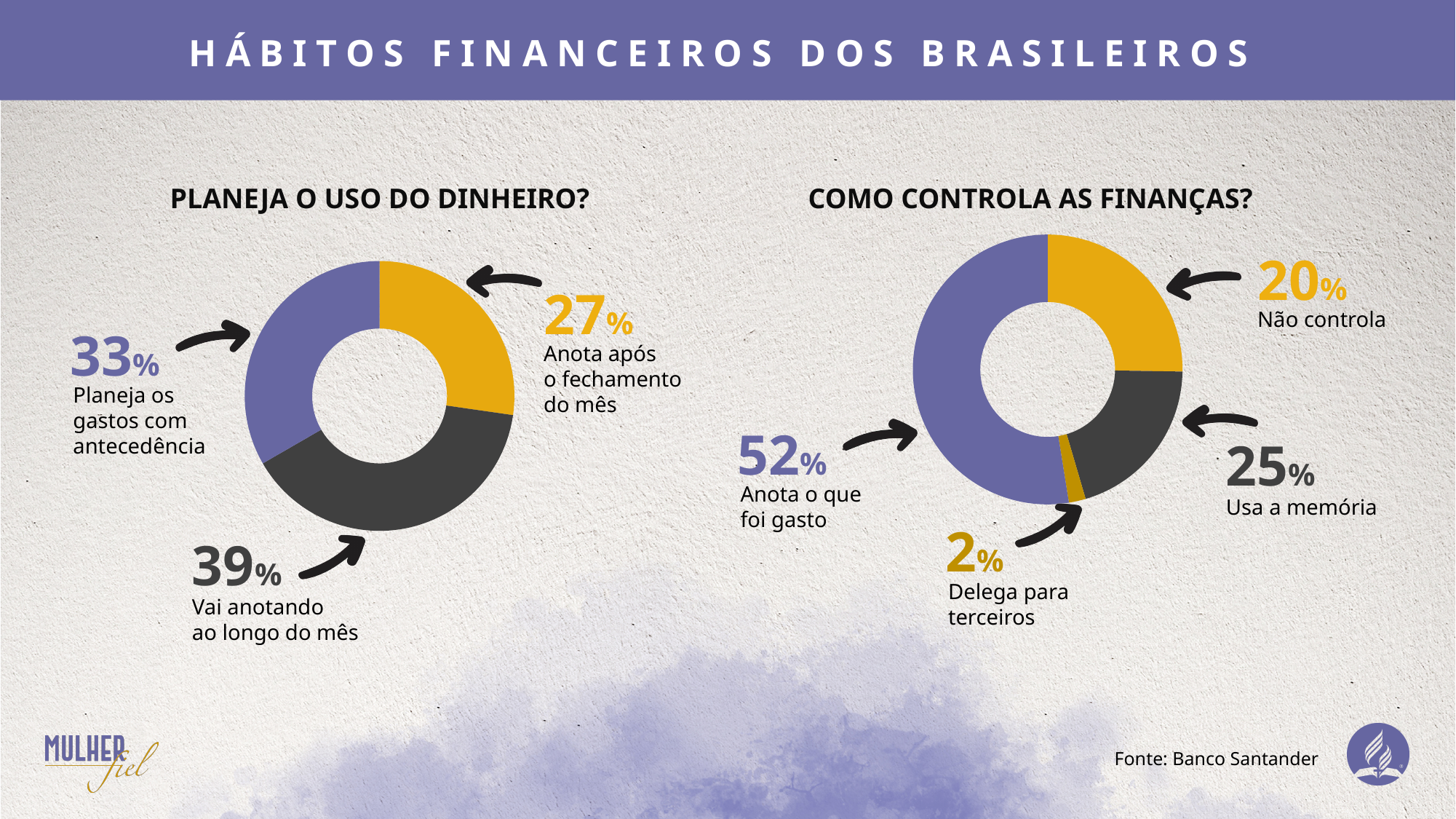
In the chart titled "PLANEJA O USO DO DINHEIRO?", what is the difference between "Vai anotando ao longo do mês" and "Anota após o fechamento do mês"? 12% In the chart titled "COMO CONTROLA AS FINANÇAS?", what percentage corresponds to "Usa a memória"? 25% In the chart titled "COMO CONTROLA AS FINANÇAS?", which category has the smallest share? Delega para terceiros In the chart titled "COMO CONTROLA AS FINANÇAS?", what percentage corresponds to "Delega para terceiros"? 2% In the chart titled "PLANEJA O USO DO DINHEIRO?", what percentage corresponds to "Vai anotando ao longo do mês"? 39% How many categories does the chart titled "COMO CONTROLA AS FINANÇAS?" show? 4 What kind of chart is the chart titled "PLANEJA O USO DO DINHEIRO?"? Doughnut chart In the chart titled "COMO CONTROLA AS FINANÇAS?", what is the difference between "Anota o que foi gasto" and "Não controla"? 32% In the chart titled "COMO CONTROLA AS FINANÇAS?", which category has the largest share? Anota o que foi gasto In the chart titled "COMO CONTROLA AS FINANÇAS?", which is larger: "Não controla" or "Usa a memória"? Usa a memória In the chart titled "PLANEJA O USO DO DINHEIRO?", what percentage corresponds to "Planeja os gastos com antecedência"? 33% In the chart titled "PLANEJA O USO DO DINHEIRO?", which category has the largest share? Vai anotando ao longo do mês